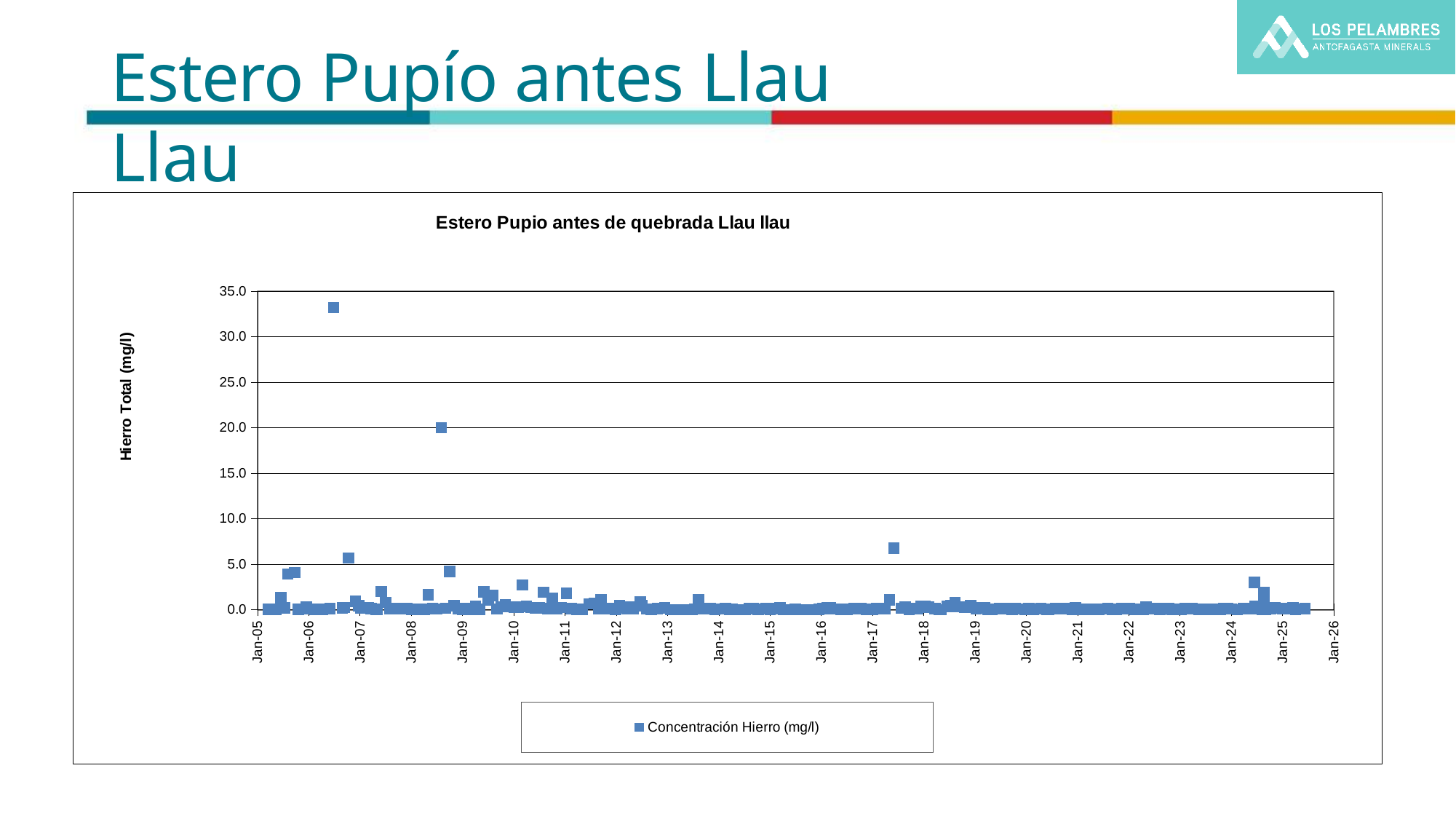
How many series does the chart legend list? 1 Is the value plotted in 2006 greater or less than the value plotted in 2017? greater What kind of chart is shown on the slide? Scatter chart Is the isolated high value plotted in 2017 greater or less than 5.0? greater In which year does the highest plotted value occur? 2006 What is the maximum value shown on the vertical axis? 35.0 Are the values plotted between Jan-19 and Jan-24 greater or less than 5.0? less What is the title of the chart? Estero Pupio antes de quebrada Llau llau What is the name of the series shown in the legend? Concentración Hierro (mg/l) Is the highest plotted value in the chart greater or less than 30.0? greater